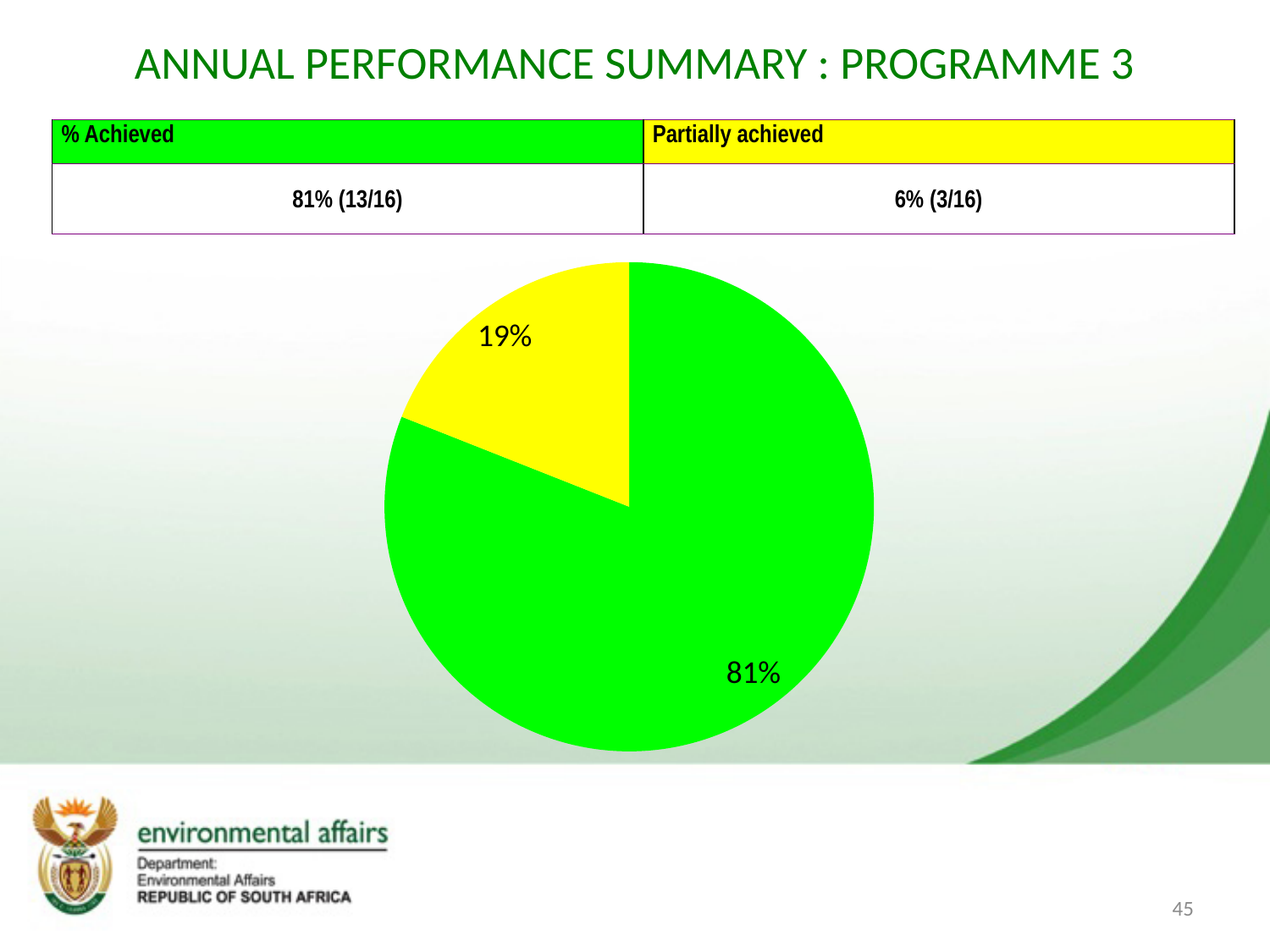
Which slice of the pie chart is the largest? The green slice (81%) Which is larger in the pie chart, the green slice or the yellow slice? The green slice Is the value of the yellow slice in the pie chart greater or less than 50%? less What percentage is shown on the yellow slice of the pie chart? 19% Which slice of the pie chart is the smallest? The yellow slice (19%) What colour is the largest slice of the pie chart? Green How many slices does the pie chart have? 2 What kind of chart is shown on the slide? Pie chart What share of the pie does the yellow slice represent? 19% What is the difference in percentage points between the green slice and the yellow slice of the pie chart? 62 percentage points What is the title of the slide containing the pie chart? ANNUAL PERFORMANCE SUMMARY : PROGRAMME 3 What percentage is shown on the green slice of the pie chart? 81%